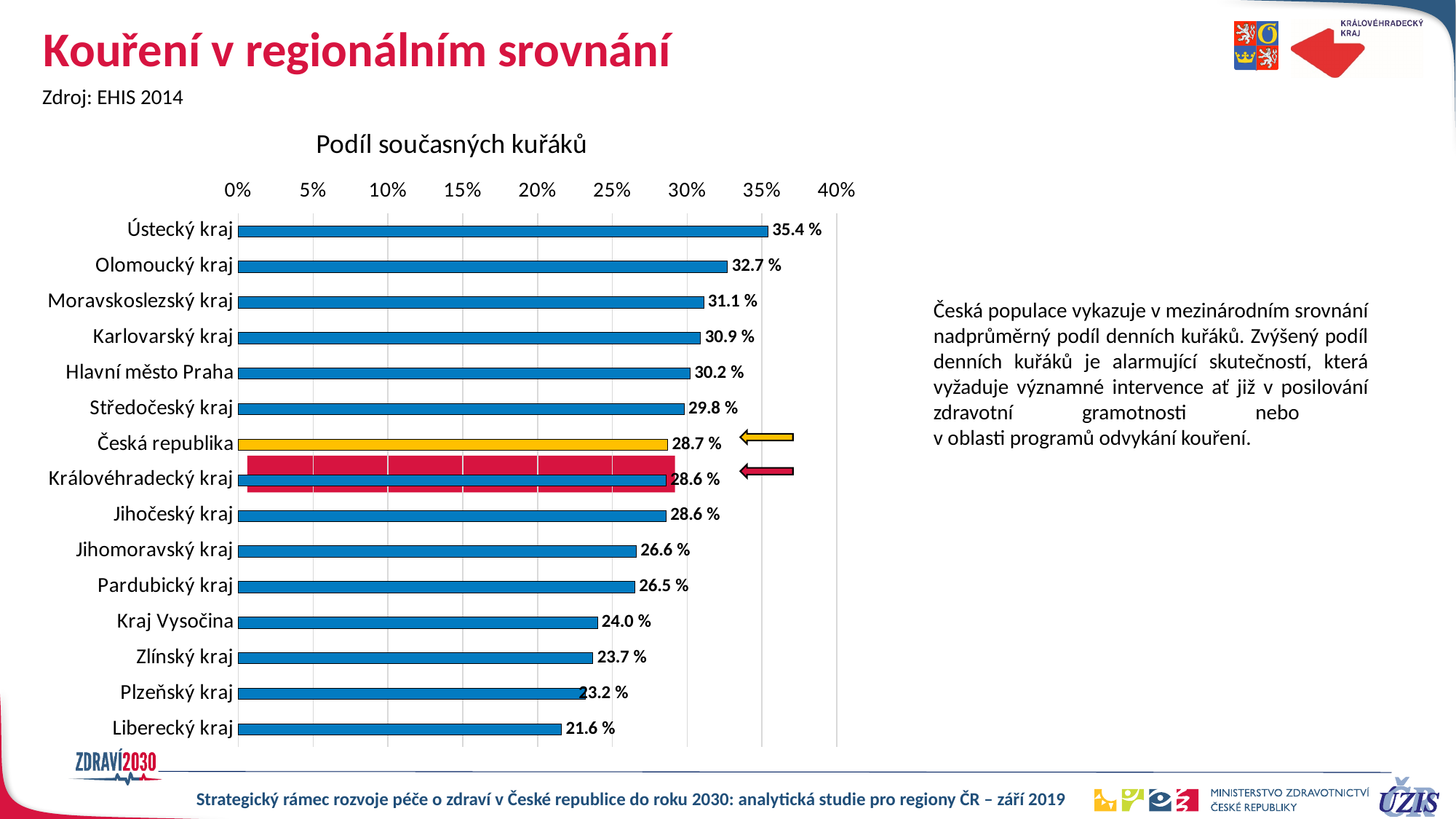
Which category has the lowest value? Liberecký kraj What is the title of the chart? Podíl současných kuřáků Which has a larger value, Olomoucký kraj or Hlavní město Praha? Olomoucký kraj How many bars are plotted in the chart? 15 What is the value for Česká republika? 28.7 % What is the value for Královéhradecký kraj? 28.6 % What is the difference between the values for Česká republika and Královéhradecký kraj? 0.1 % What is the value for Ústecký kraj? 35.4 % What is the value for Liberecký kraj? 21.6 % Which category has the highest value? Ústecký kraj What is the difference between the values for Ústecký kraj and Liberecký kraj? 13.8 % What type of chart is shown on the slide? Bar chart